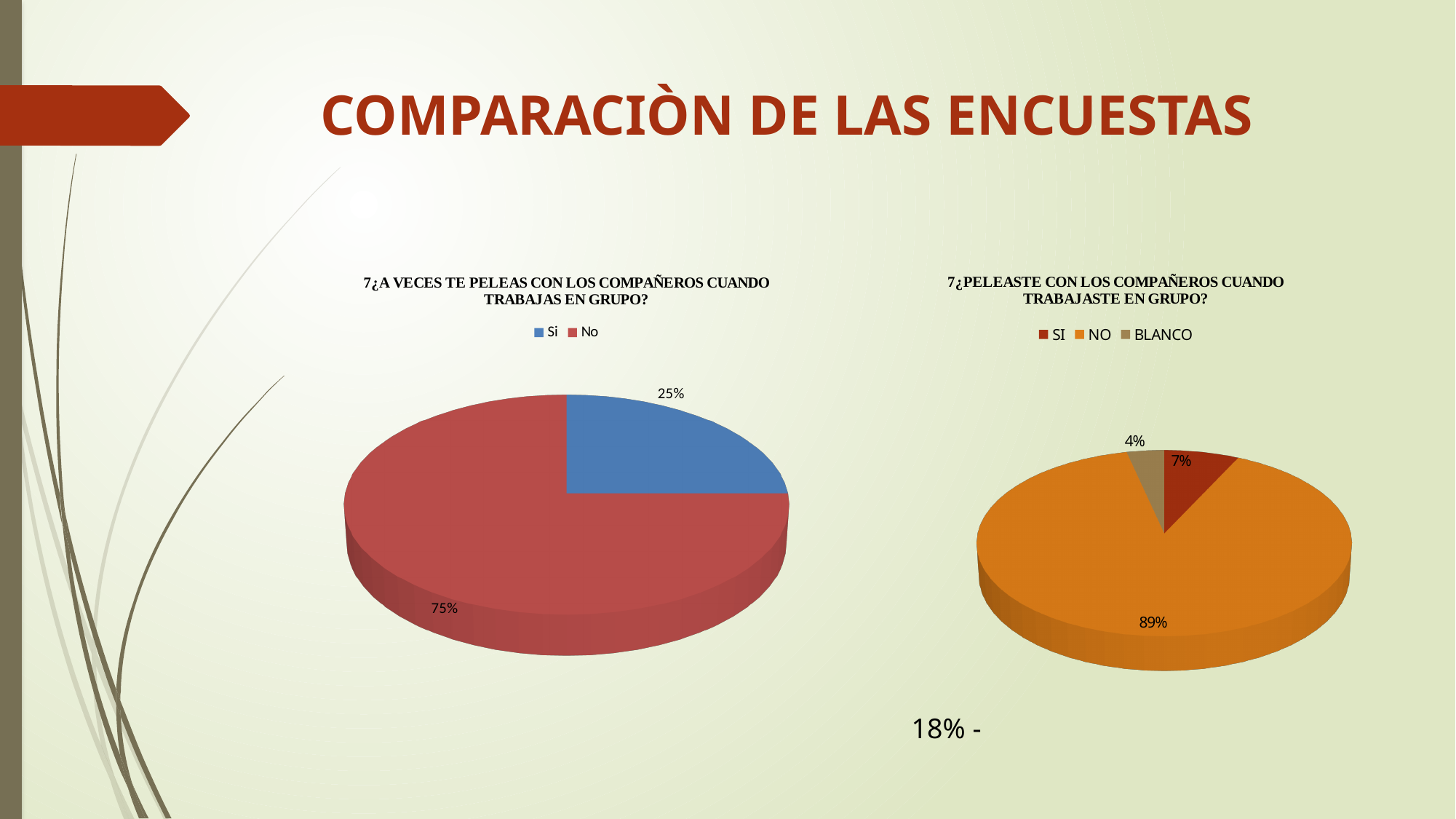
In the right chart ("7¿PELEASTE CON LOS COMPAÑEROS CUANDO TRABAJASTE EN GRUPO?"), which category has the largest slice? NO Which is larger: the "Si" share in the left chart or the "SI" share in the right chart? The "Si" share in the left chart In the left chart ("7¿A VECES TE PELEAS CON LOS COMPAÑEROS CUANDO TRABAJAS EN GRUPO?"), what is the difference between the "No" and "Si" percentages? 50% In the right chart ("7¿PELEASTE CON LOS COMPAÑEROS CUANDO TRABAJASTE EN GRUPO?"), what percentage is shown for "BLANCO"? 4% In the right chart ("7¿PELEASTE CON LOS COMPAÑEROS CUANDO TRABAJASTE EN GRUPO?"), what percentage is shown for "NO"? 89% In the right chart ("7¿PELEASTE CON LOS COMPAÑEROS CUANDO TRABAJASTE EN GRUPO?"), what is the difference between the "SI" and "BLANCO" percentages? 3% In the right chart ("7¿PELEASTE CON LOS COMPAÑEROS CUANDO TRABAJASTE EN GRUPO?"), which category has the smallest slice? BLANCO How many categories does the legend of the right chart ("7¿PELEASTE CON LOS COMPAÑEROS CUANDO TRABAJASTE EN GRUPO?") list? 3 In the left chart ("7¿A VECES TE PELEAS CON LOS COMPAÑEROS CUANDO TRABAJAS EN GRUPO?"), what percentage is shown for "Si"? 25% What type of chart is the left chart ("7¿A VECES TE PELEAS CON LOS COMPAÑEROS CUANDO TRABAJAS EN GRUPO?")? Pie chart In the left chart ("7¿A VECES TE PELEAS CON LOS COMPAÑEROS CUANDO TRABAJAS EN GRUPO?"), what percentage is shown for "No"? 75% In the right chart ("7¿PELEASTE CON LOS COMPAÑEROS CUANDO TRABAJASTE EN GRUPO?"), what percentage is shown for "SI"? 7%